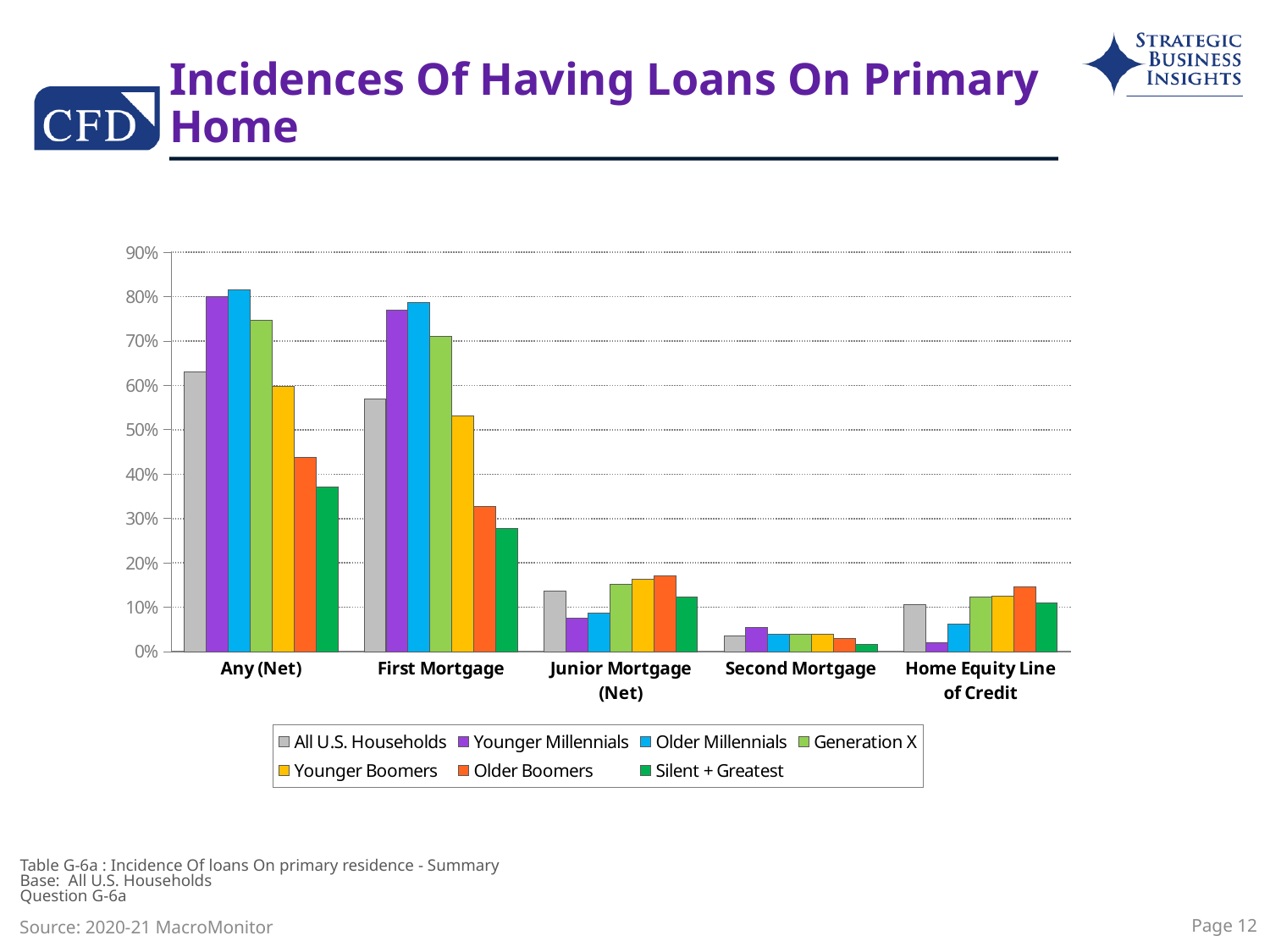
How many series does the legend list? 7 Is the value for Older Boomers in the Any (Net) category greater or less than 40%? greater Is the value for All U.S. Households in the Any (Net) category greater or less than 60%? greater Is the value for Younger Millennials in the Second Mortgage category greater or less than 10%? less In the First Mortgage category, which is larger: Generation X or Younger Boomers? Generation X Which series has the lowest value in the Any (Net) category? Silent + Greatest Which series has the highest value in the Home Equity Line of Credit category? Older Boomers In the Junior Mortgage (Net) category, which is larger: All U.S. Households or Younger Millennials? All U.S. Households How many loan categories are shown along the x axis? 5 What kind of chart is shown on the slide? Bar chart Which series has the lowest value in the Home Equity Line of Credit category? Younger Millennials